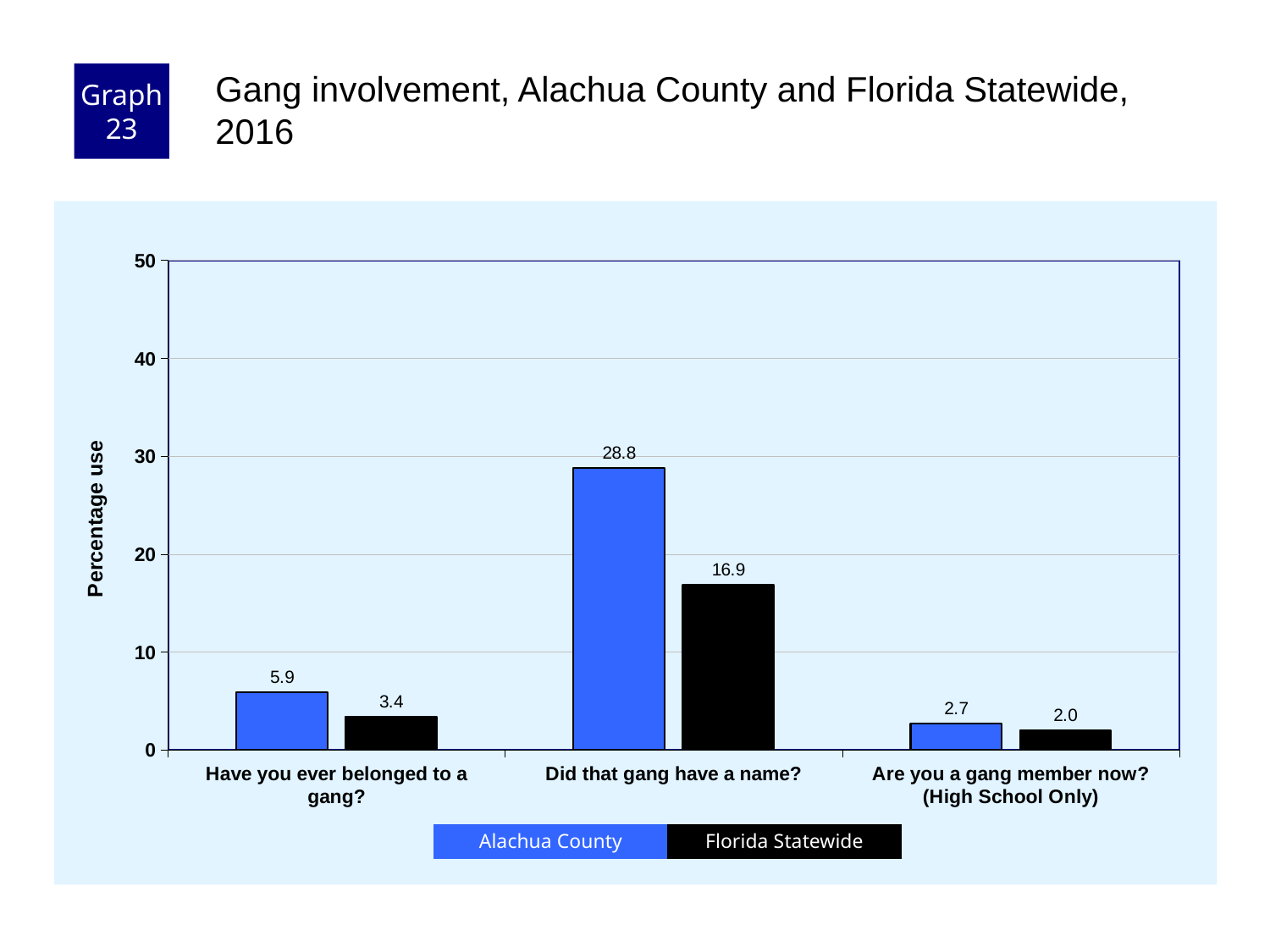
How many series does the legend list? 2 What is the Florida Statewide value for "Are you a gang member now? (High School Only)"? 2.0 How many questions (categories) are shown on the x axis? 3 What is the label on the y axis? Percentage use What is the Alachua County value for "Did that gang have a name?"? 28.8 What is the difference between the Alachua County and Florida Statewide values for "Did that gang have a name?"? 11.9 For "Have you ever belonged to a gang?", which is larger: Alachua County or Florida Statewide? Alachua County What kind of chart is shown on the slide? Bar chart Which question has the lowest Florida Statewide value? Are you a gang member now? (High School Only) What is the Florida Statewide value for "Have you ever belonged to a gang?"? 3.4 Is the Florida Statewide value for "Did that gang have a name?" greater or less than 20? less Which question has the highest Alachua County value? Did that gang have a name?